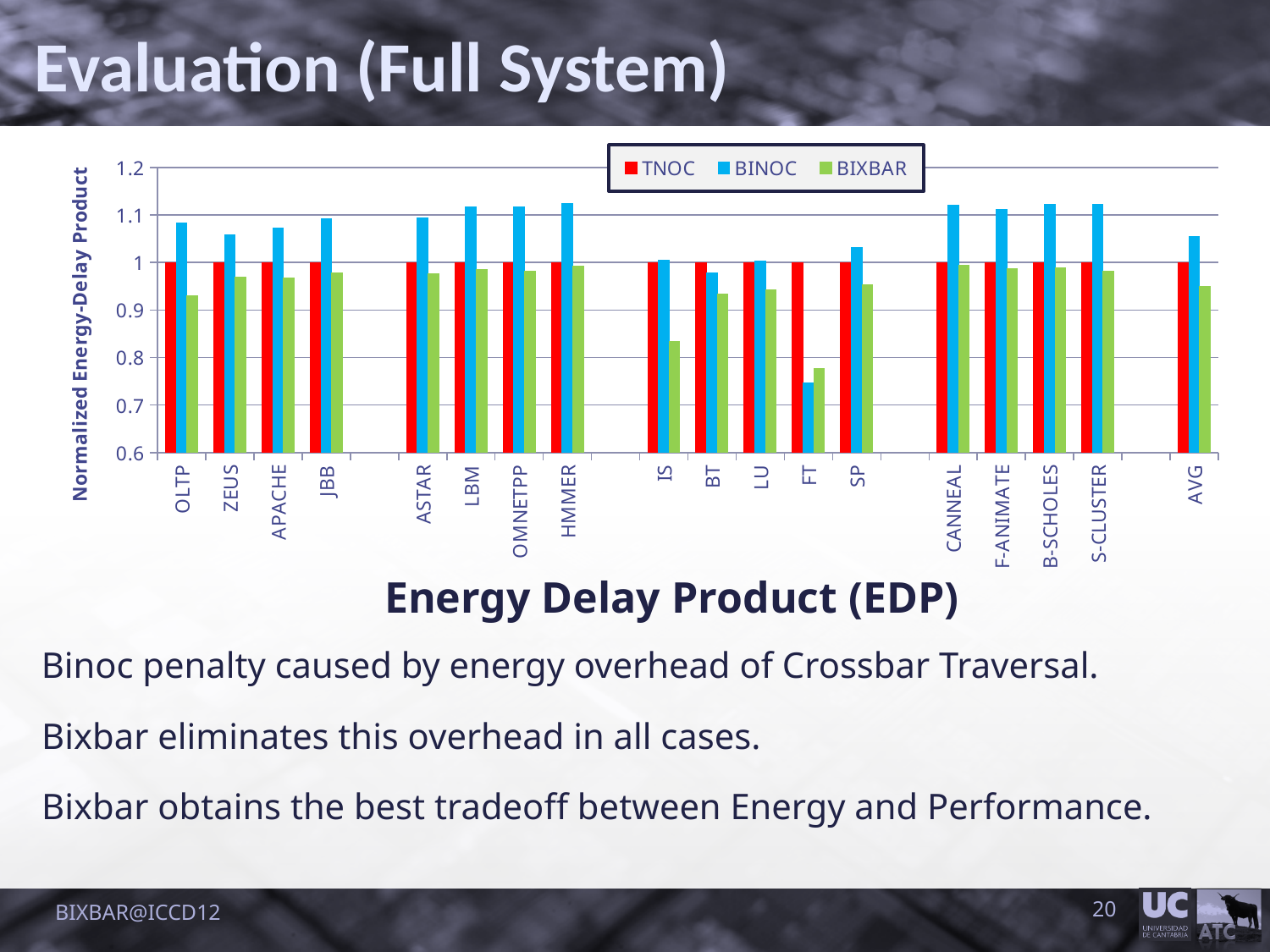
Which category has the lowest BINOC value? FT How many categories are shown along the x axis of the chart? 18 What kind of chart is shown on the slide? bar chart What is the TNOC value for OLTP? 1 What is the label of the vertical axis of the chart? Normalized Energy-Delay Product Is the BIXBAR value for IS greater or less than 0.9? less Is the BINOC value for FT greater or less than 0.8? less Which is larger for OLTP, the BINOC value or the BIXBAR value? BINOC Is the BINOC value for OLTP greater or less than 1? greater What is the TNOC value for AVG? 1 How many series does the chart legend list? 3